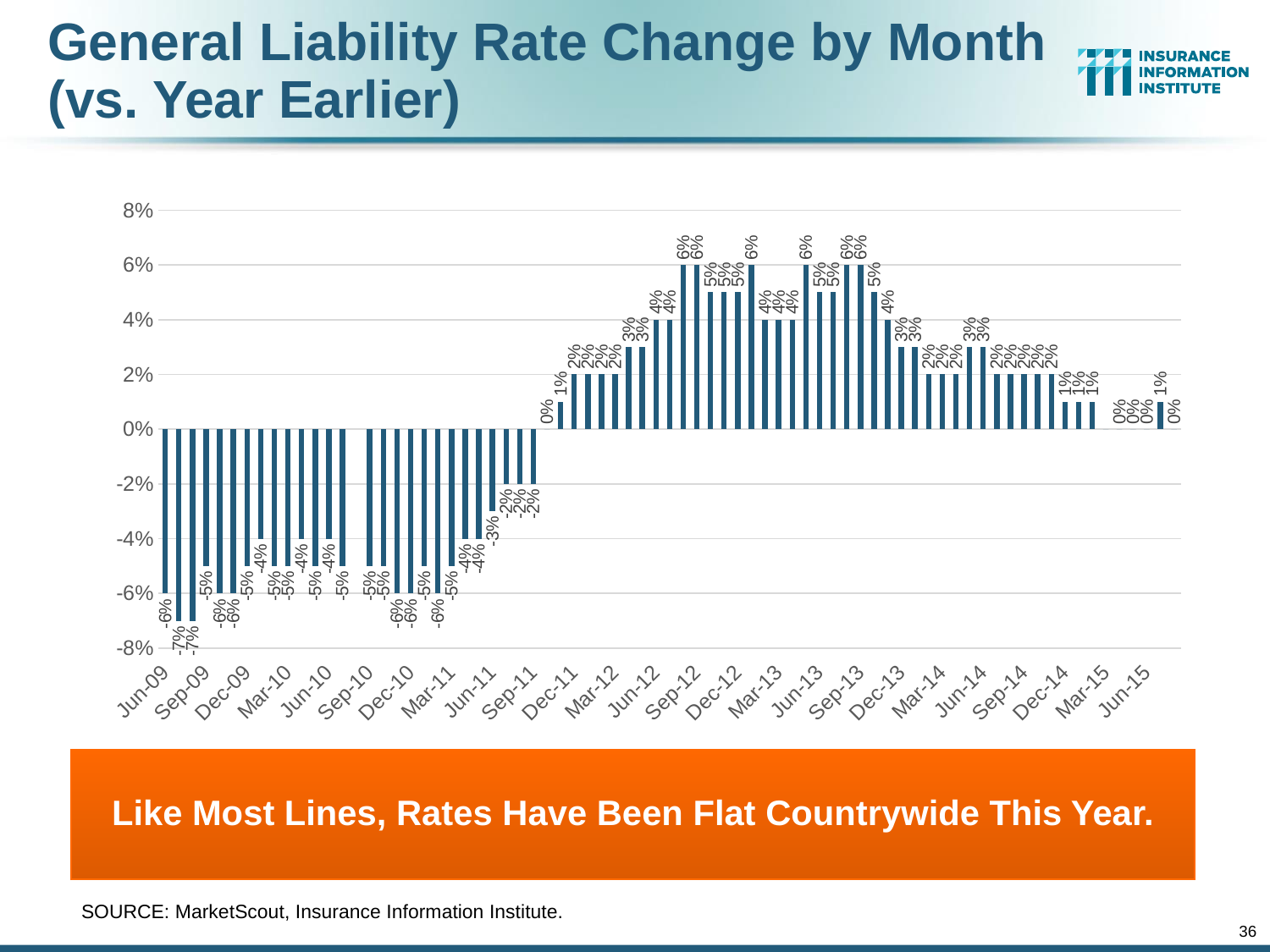
Which is larger, the rate change for Jun-09 or for Sep-12? Sep-12 Is the value for Jun-09 greater or less than -4%? less What is the rate change for Sep-09? -5% What is the rate change for Sep-12? 6% What kind of chart is shown on the slide? bar chart What is the source cited for the chart? MarketScout, Insurance Information Institute What is the highest rate change value shown in the chart? 6% What is the lowest rate change value shown in the chart? -7% Do the values rise or fall from Jun-09 to Sep-12? rise What is the title of the chart? General Liability Rate Change by Month (vs. Year Earlier) Is the value for Sep-12 greater or less than 4%? greater What is the rate change for Jun-09? -6%